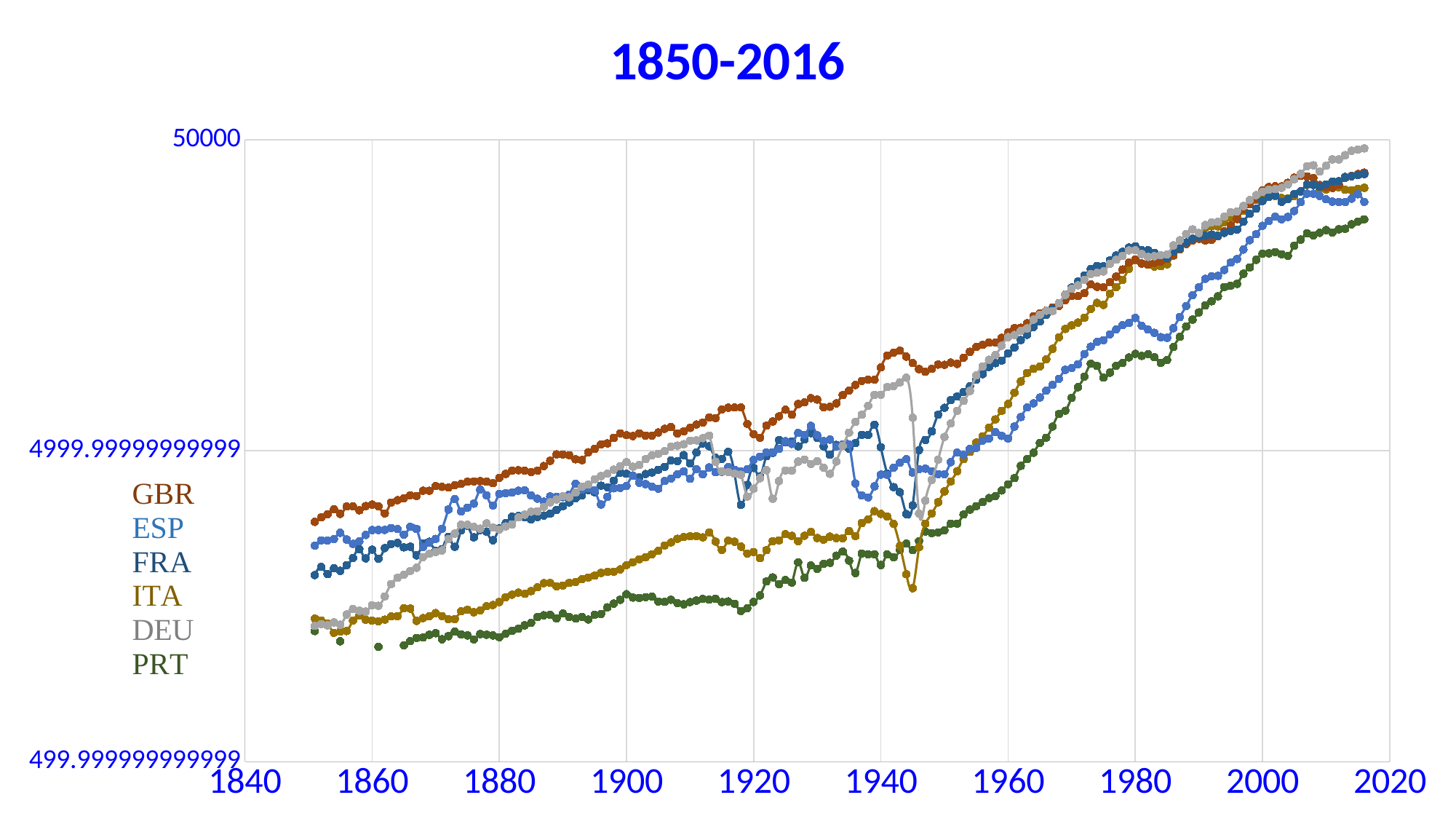
How many series does the legend list? 6 Do the values for the series generally rise or fall from 1850 to 2016? rise Which series has the lowest value at the right end of the chart (around 2016)? PRT Is the value for GBR in 1850 greater or less than 5000? less Is the value for DEU in 2016 greater or less than 5000? greater Which is larger around 1900, the value for GBR or the value for PRT? GBR What kind of chart is shown on the slide? line chart Which series has the highest value at the start of the chart (around 1850)? GBR Is the value for PRT in 1850 greater or less than 5000? less Which series has the highest value at the right end of the chart (around 2016)? DEU Which series shows the sharpest drop around 1945? DEU What is the title of the chart? 1850-2016